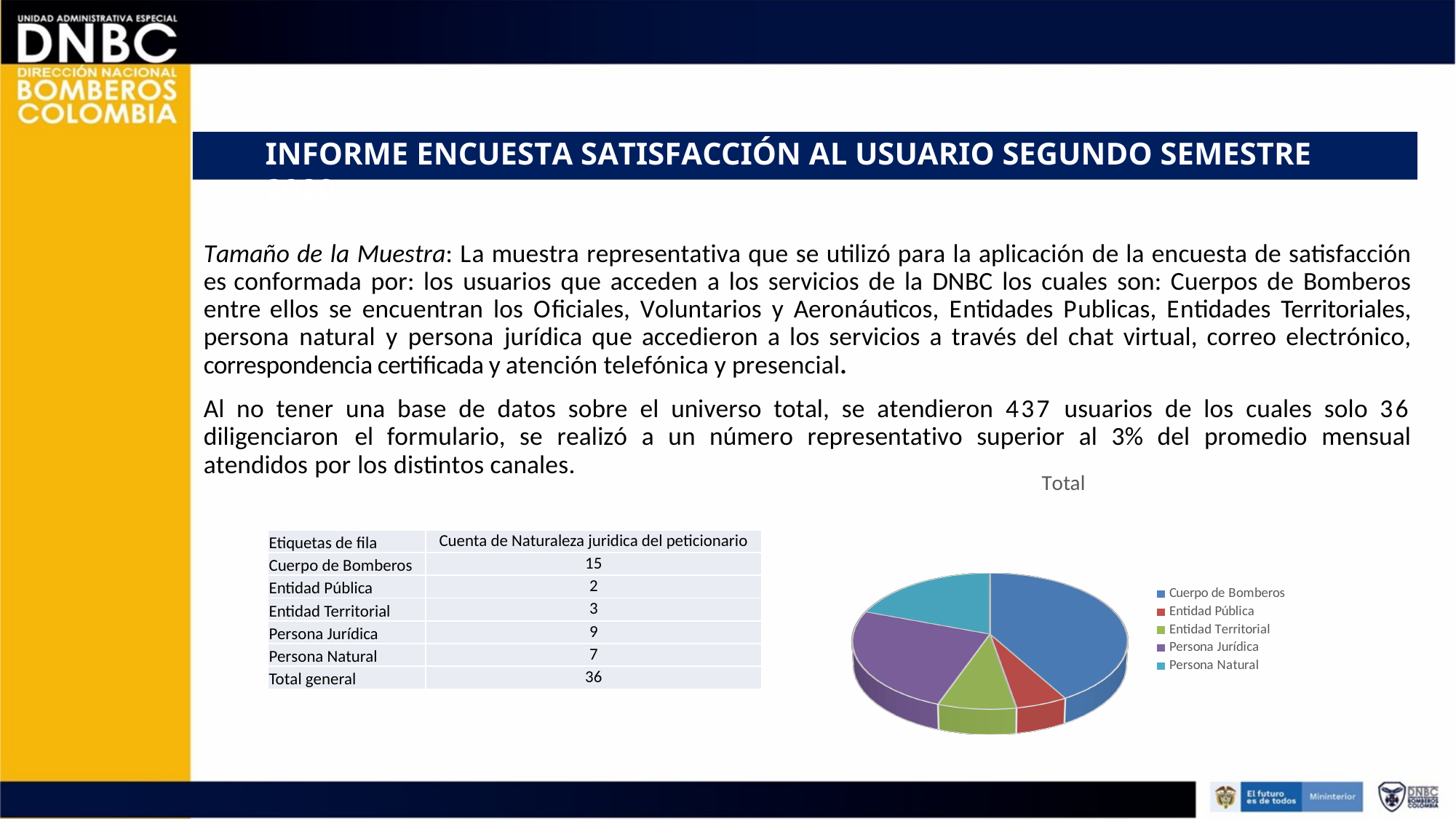
According to the table next to the pie chart, what is the count for Cuerpo de Bomberos? 15 Which category has the smallest slice in the pie chart? Entidad Pública What kind of chart is shown on the slide? pie chart In the pie chart, which slice is larger: Persona Jurídica or Persona Natural? Persona Jurídica Using the values in the table, what is the difference between the counts for Cuerpo de Bomberos and Persona Natural? 8 Which category has the largest slice in the pie chart? Cuerpo de Bomberos How many slices does the pie chart have? 5 How many entries does the legend of the pie chart list? 5 What is the total of all categories shown in the table next to the pie chart? 36 In the pie chart, which slice is larger: Cuerpo de Bomberos or Persona Jurídica? Cuerpo de Bomberos According to the table next to the pie chart, what is the count for Persona Jurídica? 9 What is the title of the pie chart? Total